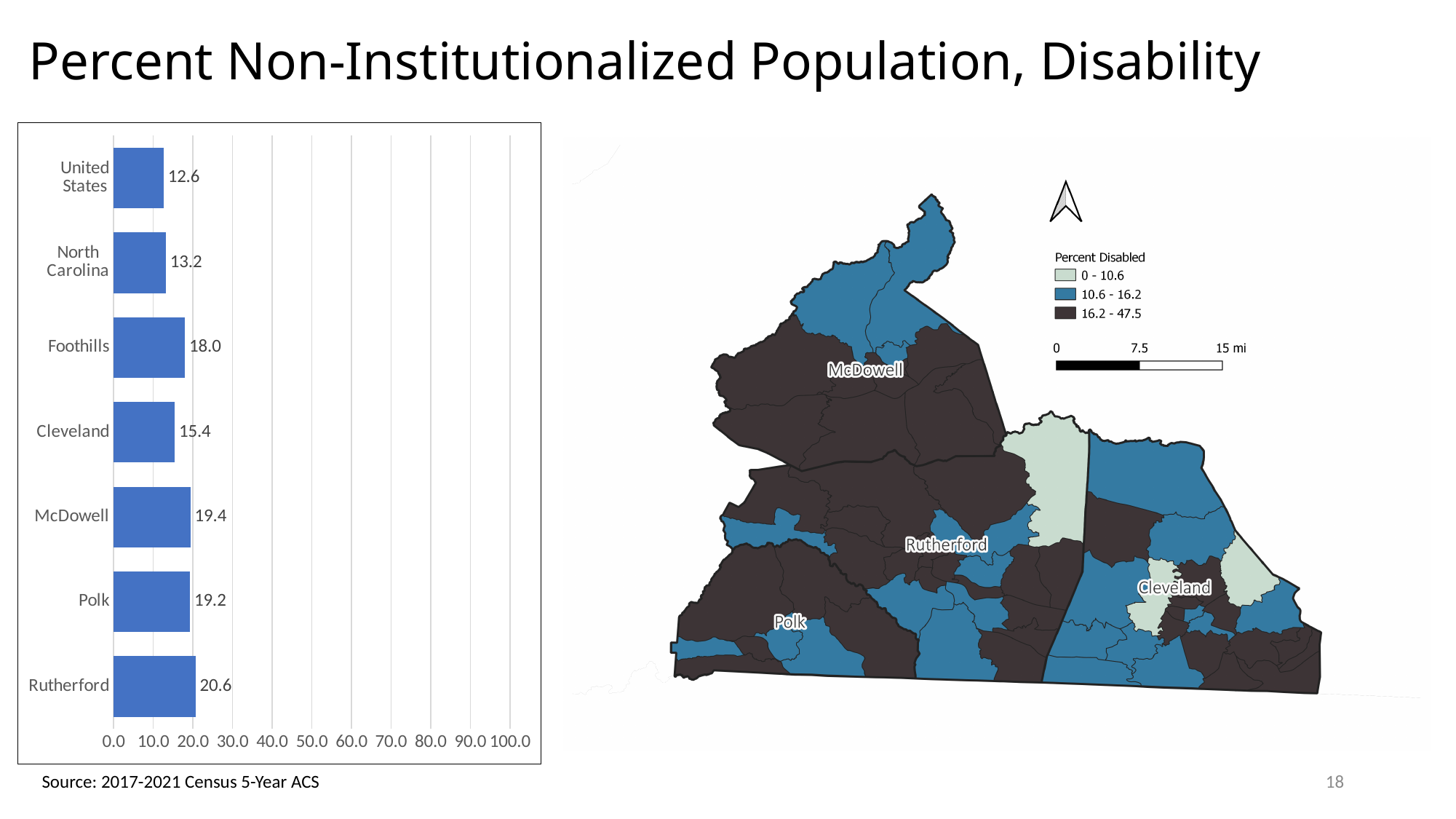
Which category has the highest value in the bar chart? Rutherford How many categories are shown in the bar chart? 7 Which category has the lowest value in the bar chart? United States What is the value for Foothills in the bar chart? 18.0 What is the maximum value shown on the x axis of the bar chart? 100.0 Which is larger in the bar chart, the value for Polk or the value for Foothills? Polk What kind of chart is shown on the left of the slide? Bar chart What is the difference between the values for McDowell and Cleveland in the bar chart? 4.0 Is the value for North Carolina in the bar chart greater or less than 20.0? less What is the value for the United States in the bar chart? 12.6 What is the difference between the values for Rutherford and the United States in the bar chart? 8.0 What is the value for Rutherford in the bar chart? 20.6